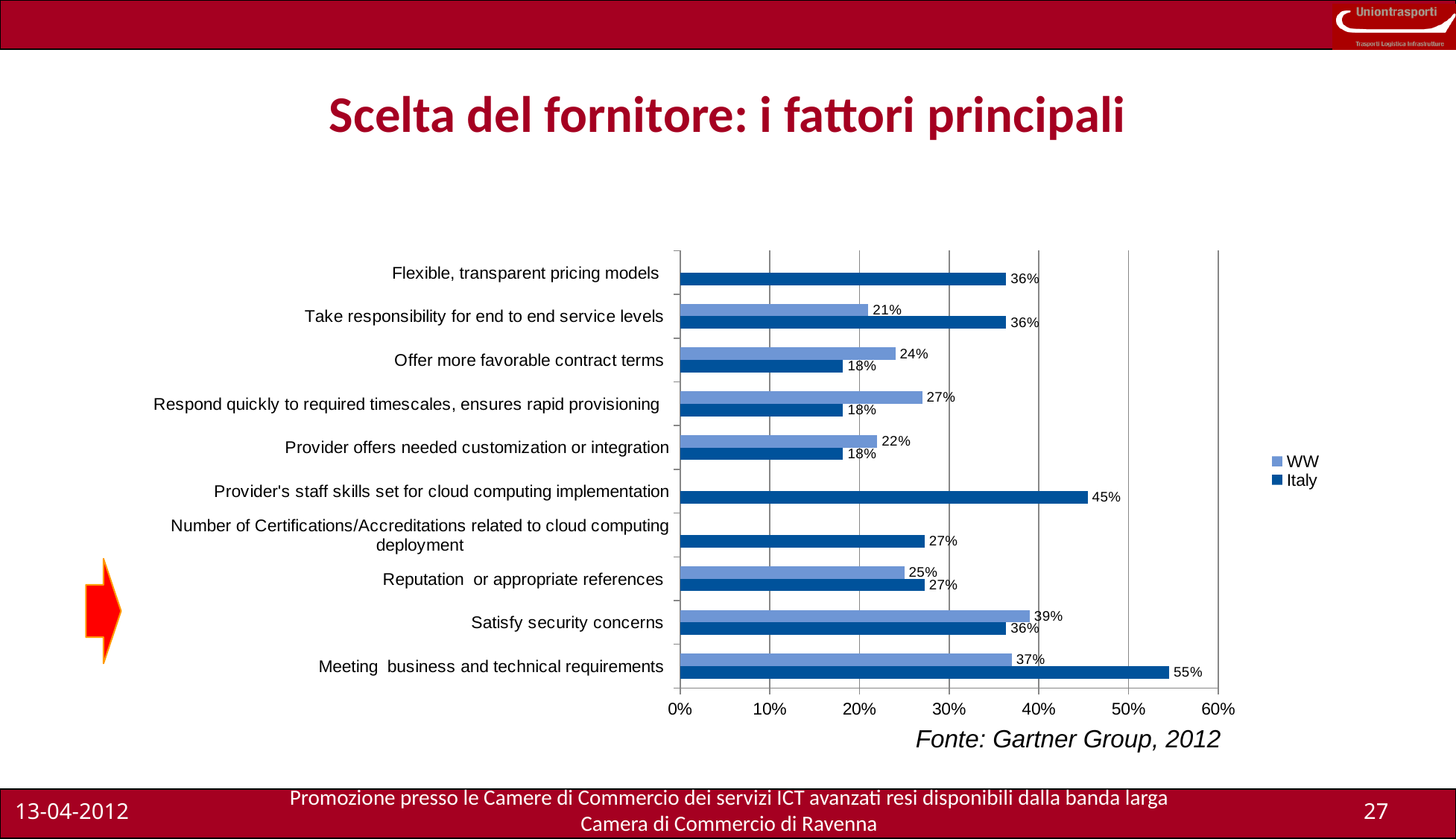
How many categories are shown on the chart? 10 Which category has the highest WW value? Satisfy security concerns Which category has the lowest WW value among those with a WW bar? Take responsibility for end to end service levels For Respond quickly to required timescales, ensures rapid provisioning, which is larger: the WW value or the Italy value? WW Which category has the highest Italy value? Meeting business and technical requirements What is the difference between the Italy and WW values for Meeting business and technical requirements? 18% What is the Italy value for Provider's staff skills set for cloud computing implementation? 45% How many series does the legend list? 2 What kind of chart is shown on the slide? Bar chart What is the WW value for Satisfy security concerns? 39% What is the Italy value for Meeting business and technical requirements? 55% What is the WW value for Offer more favorable contract terms? 24%